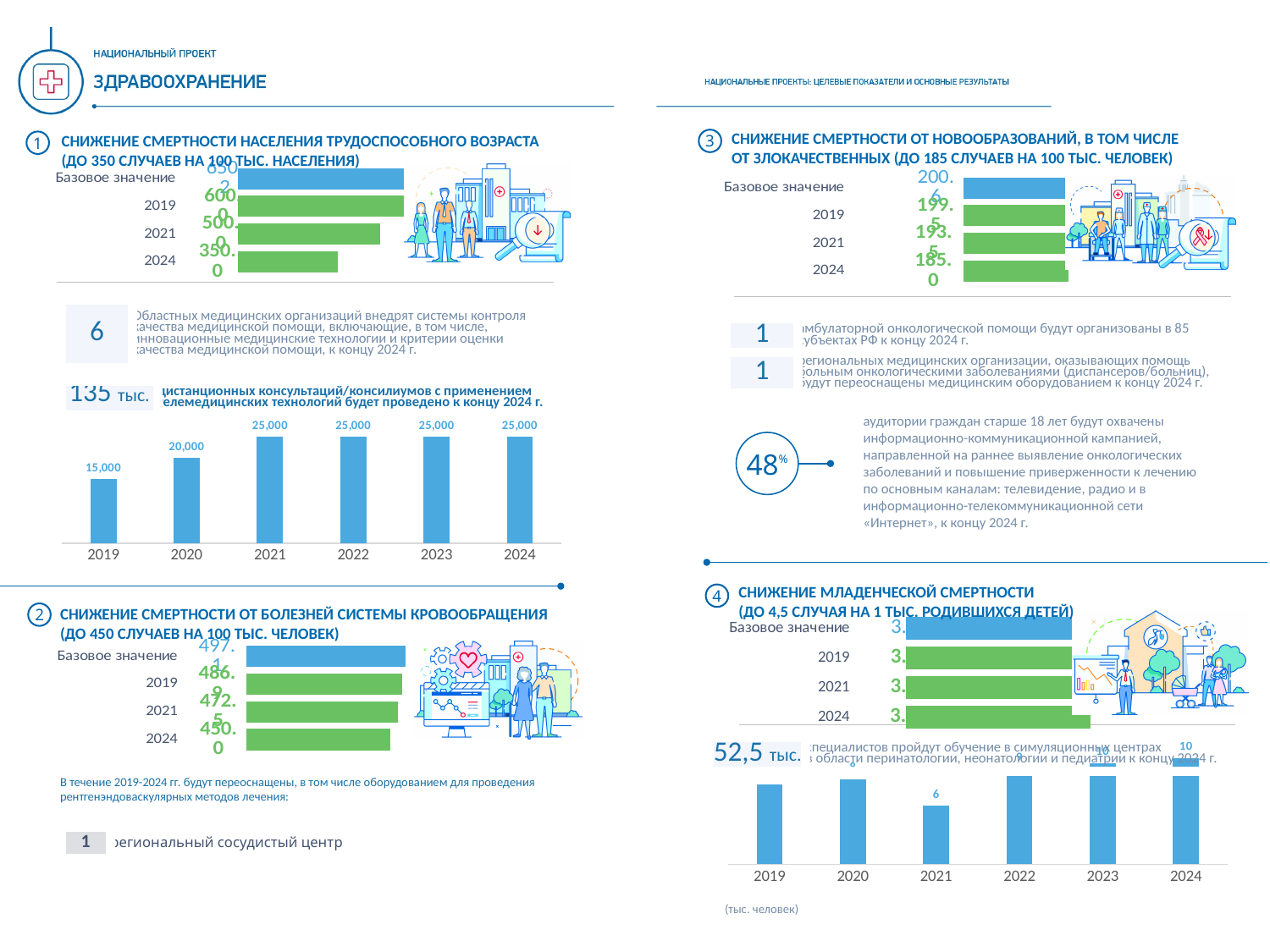
In the chart of distance consultations on the left, what is the value for 2020? 20,000 In the chart under heading 3 (снижение смертности от новообразований), what is the value for 2021? 193.5 In the chart under heading 2 (снижение смертности от болезней системы кровообращения), what is the value for 2024? 450.0 In the chart under heading 2 (снижение смертности от болезней системы кровообращения), which is larger, the value for 2019 or for 2024? 2019 In the chart of distance consultations (дистанционных консультаций) on the left, what is the value for 2019? 15,000 In the chart of distance consultations on the left, what is the difference between the values for 2020 and 2019? 5,000 In the chart of distance consultations on the left, do the values rise or fall from 2019 to 2021? rise What kind of chart is the distance consultations chart on the left? bar chart In the bar chart of specialists trained in simulation centres at the bottom right, which year has the lowest value? 2021 In the chart of distance consultations on the left, which year has the lowest value? 2019 In the chart of distance consultations on the left, how many years are shown on the x axis? 6 In the chart under heading 3 (снижение смертности от новообразований), what is the value for 2024? 185.0